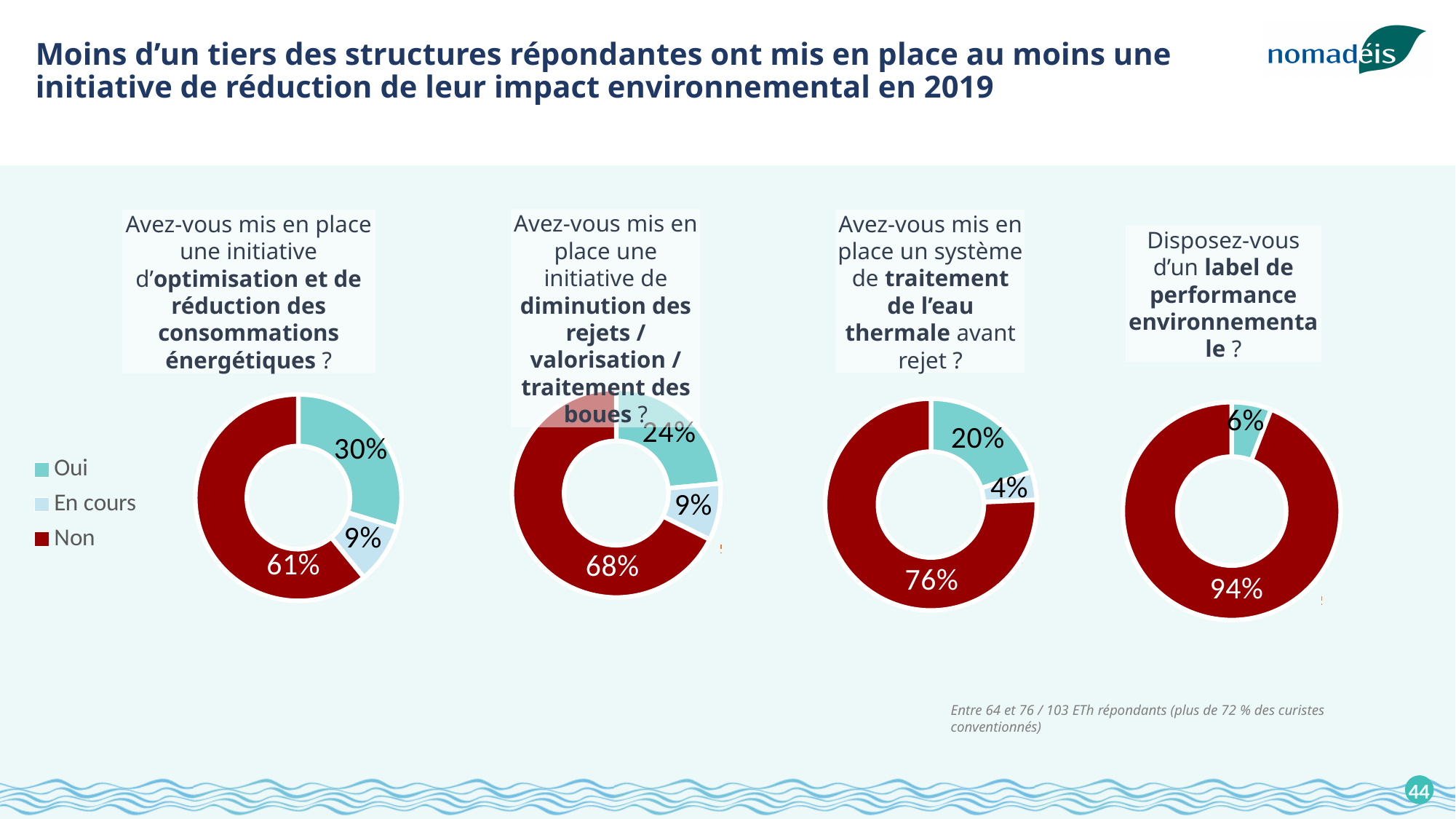
In the leftmost donut chart (consommations énergétiques), what share answered "Non"? 61% In the leftmost donut chart (optimisation et réduction des consommations énergétiques), what share answered "Oui"? 30% In the second donut chart from the left (diminution des rejets / valorisation / traitement des boues), what share answered "Oui"? 24% In the second donut chart from the left (rejets / boues), what share answered "Non"? 68% What type of chart is used on this slide? Donut (pie) chart How many entries does the shared legend list? 3 Which is larger: the "Oui" share in the leftmost chart (consommations énergétiques) or the "Oui" share in the third chart (eau thermale)? Leftmost chart (consommations énergétiques) In the third donut chart from the left (traitement de l'eau thermale), which answer has the largest share? Non What is the difference between the "Non" share in the rightmost chart (label) and the "Non" share in the leftmost chart (consommations énergétiques)? 33 percentage points In the third donut chart from the left (traitement de l'eau thermale), what share answered "En cours"? 4% In the rightmost donut chart (label de performance environnementale), what share answered "Non"? 94%